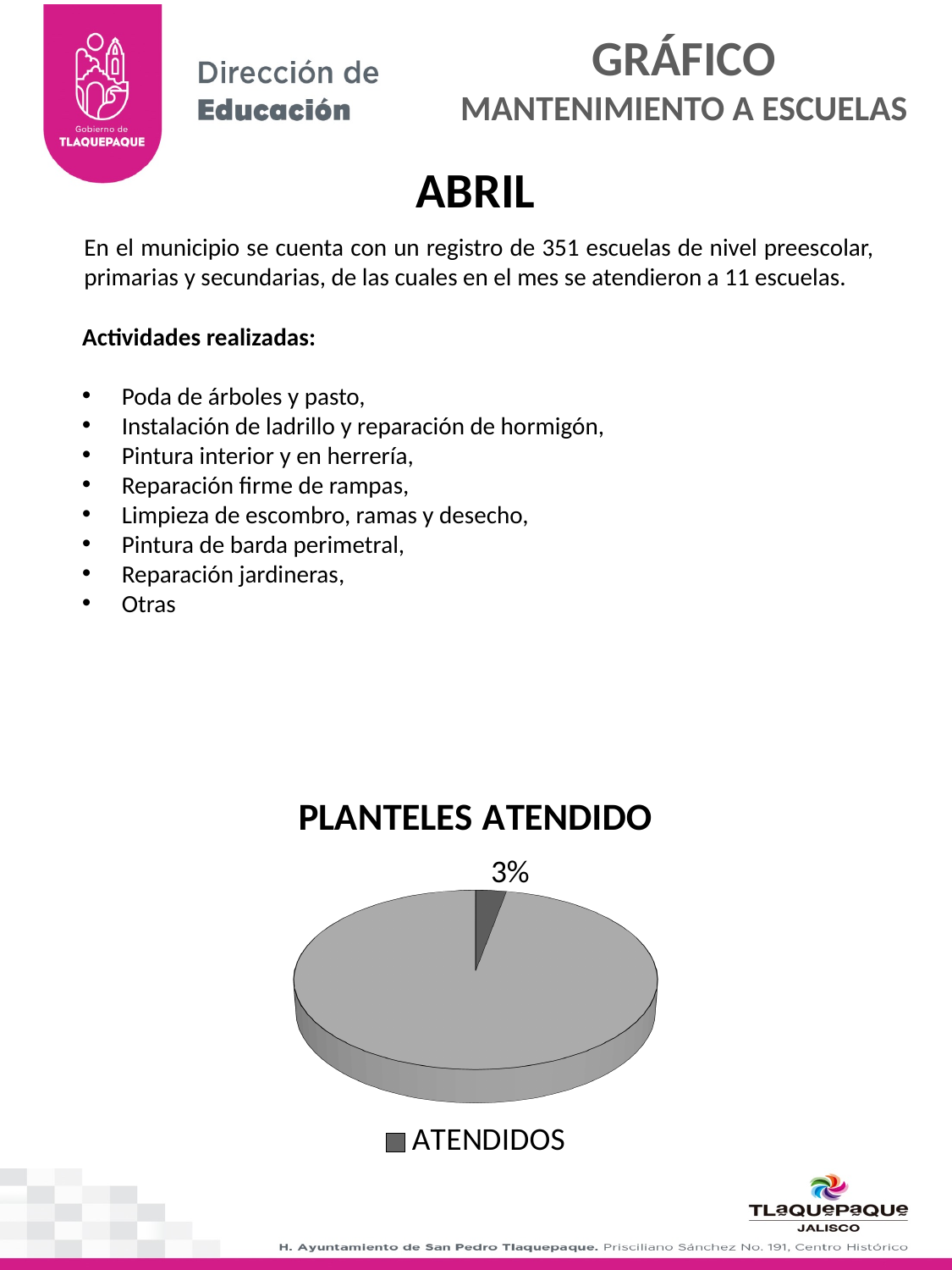
What percentage is printed on the labelled slice of the pie chart? 3% How many entries does the chart's legend list? 1 What kind of chart is shown on the slide? pie chart Is the labelled slice of the pie chart larger or smaller than the unlabelled slice? smaller Is the share of the labelled slice greater or less than 50%? less How many slices does the pie chart have? 2 What share of the pie does the ATENDIDOS slice represent? 3% What is the legend entry shown below the pie chart? ATENDIDOS What is the title of the chart on the slide? PLANTELES ATENDIDO